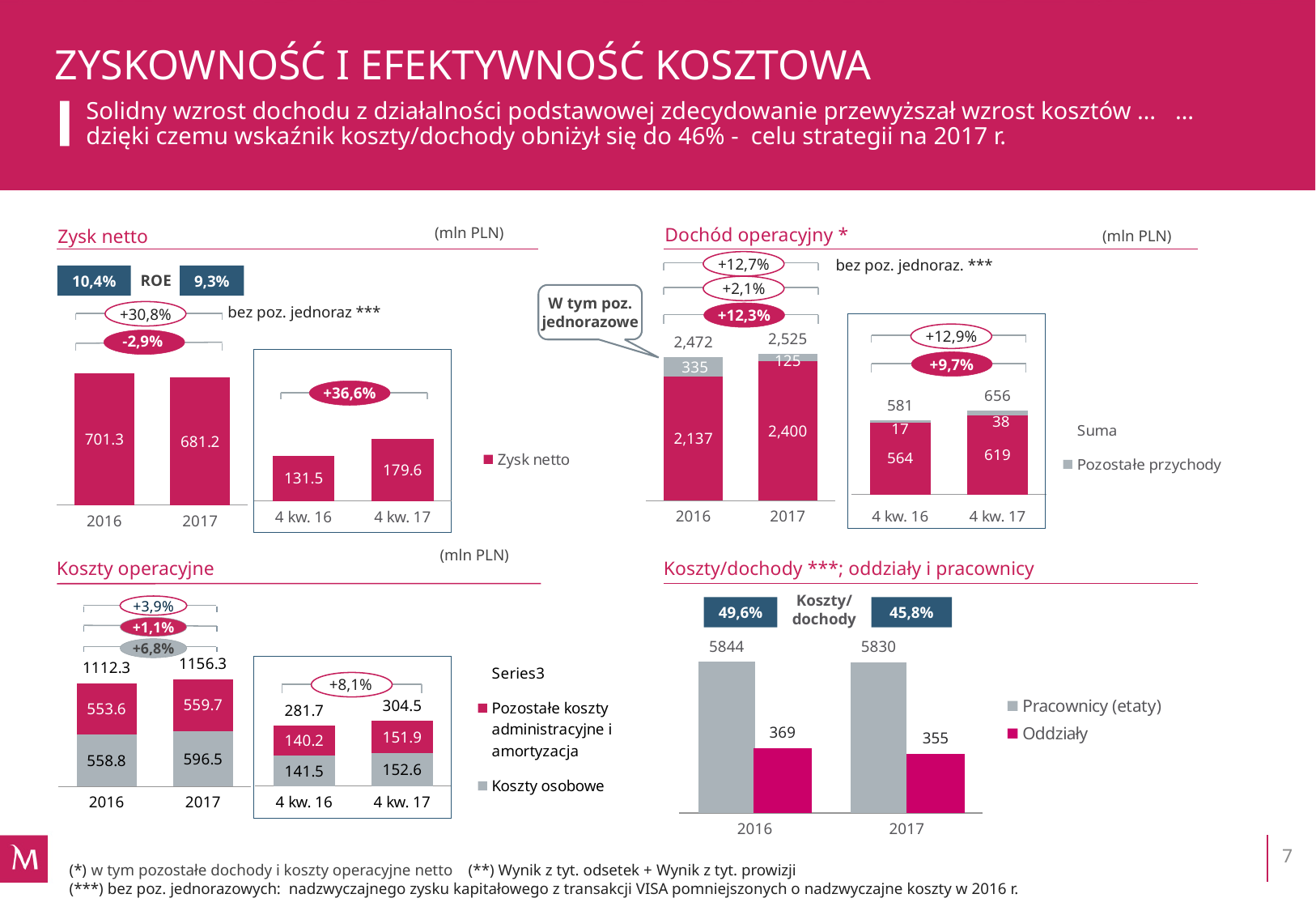
In the 'Koszty operacyjne' chart, what is the 'Koszty osobowe' value for 2017? 596.5 In the 'Dochód operacyjny *' chart, what is the total for the 2017 bar? 2,525 How many series does the legend of the 'Koszty/dochody ***; oddziały i pracownicy' chart list? 2 In the 'Koszty/dochody ***; oddziały i pracownicy' chart, what is the 'Oddziały' value for 2017? 355 In the 'Zysk netto' chart, what is the value for 4 kw. 17? 179.6 In the 'Dochód operacyjny *' chart, what is the total for the 4 kw. 17 bar? 656 In the 'Koszty operacyjne' chart, what is the total for the 4 kw. 16 bar? 281.7 In the 'Koszty operacyjne' chart, what is the difference between the 2017 and 2016 totals? 44.0 In the 'Zysk netto' chart, which year has the higher net profit, 2016 or 2017? 2016 In the 'Zysk netto' chart, what is the difference between the 4 kw. 17 and 4 kw. 16 values? 48.1 In the 'Dochód operacyjny *' chart, what is the 'Pozostałe przychody' value for 2016? 335 In the 'Zysk netto' chart, what is the net profit value for 2016? 701.3